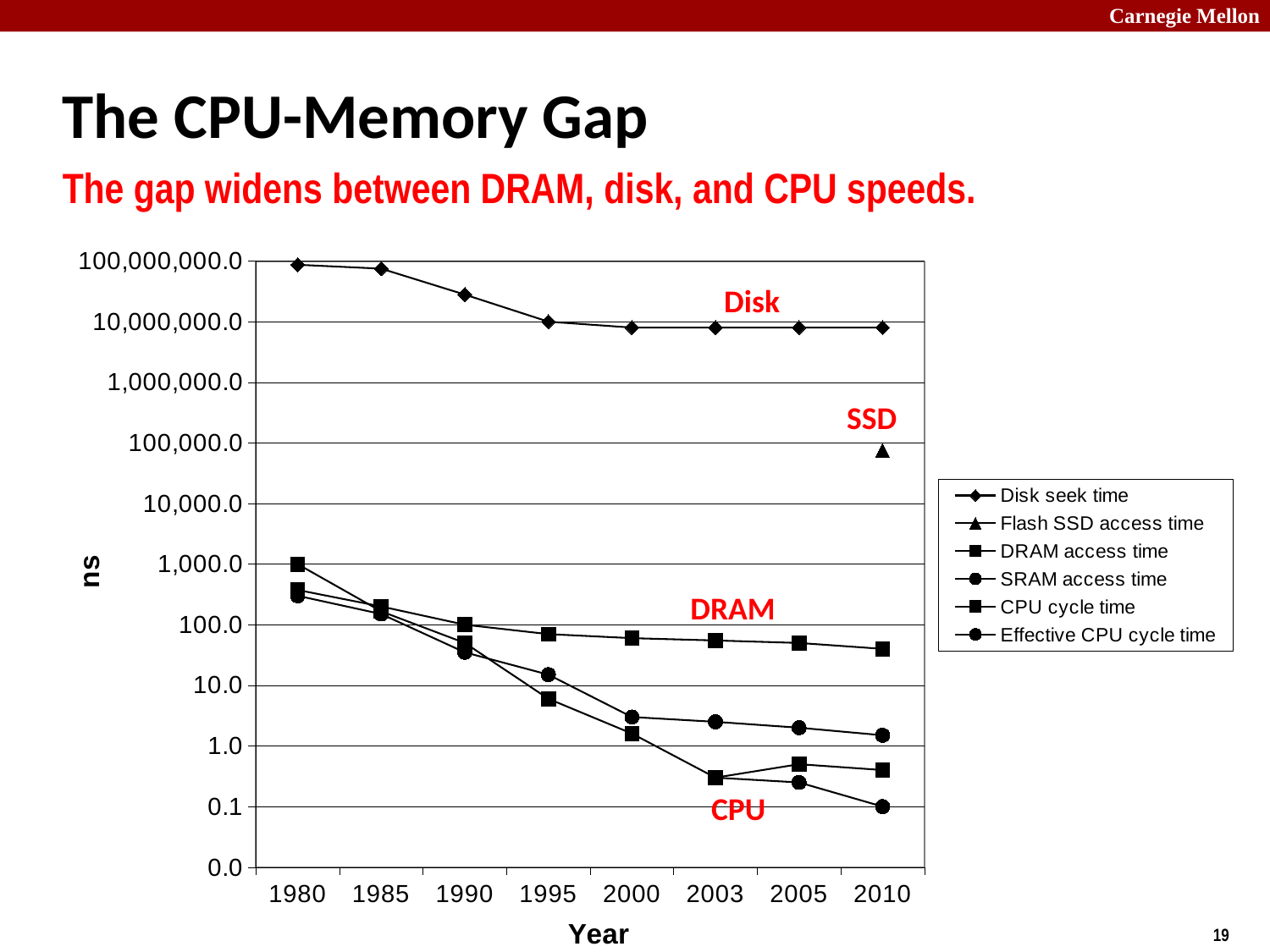
What is the label of the y axis? ns What kind of chart is shown on the slide? line chart What is the Disk seek time value in 1995? 10,000,000.0 How many years are marked on the x axis? 8 What is the Effective CPU cycle time value in 2010? 0.1 Is the Flash SSD access time value in 2010 greater or less than 100,000.0? less What is the CPU cycle time value in 1980? 1,000.0 Is the DRAM access time value in 2010 greater or less than 100.0? less Which series has the highest value in 2010? Disk seek time How many series does the legend list? 6 Does the Disk seek time rise or fall from 1980 to 2010? fall Which series has the lowest value in 2010? Effective CPU cycle time